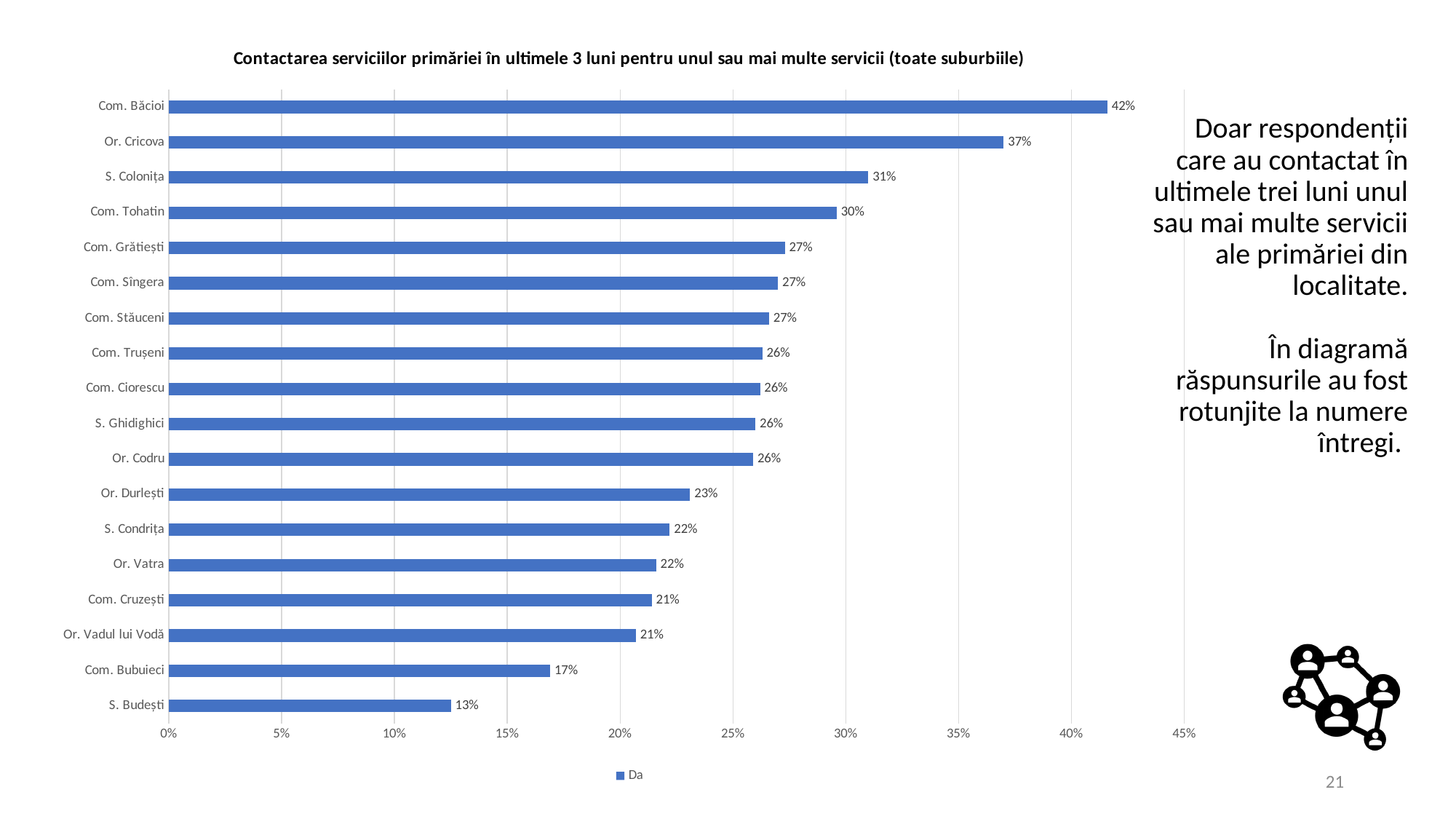
What is the difference between the values for Or. Cricova and S. Colonița? 6% What is the value for Com. Băcioi? 42% Which category has the highest value? Com. Băcioi What is the single legend entry shown below the chart? Da What is the value for Or. Durlești? 23% What is the value for S. Budești? 13% What is the difference between the values for Com. Băcioi and S. Budești? 29% Which category has the lowest value? S. Budești What is the value for Or. Cricova? 37% Which is larger, the value for Com. Tohatin or the value for Com. Bubuieci? Com. Tohatin How many categories are shown in the chart? 18 What kind of chart is shown on the slide? Bar chart